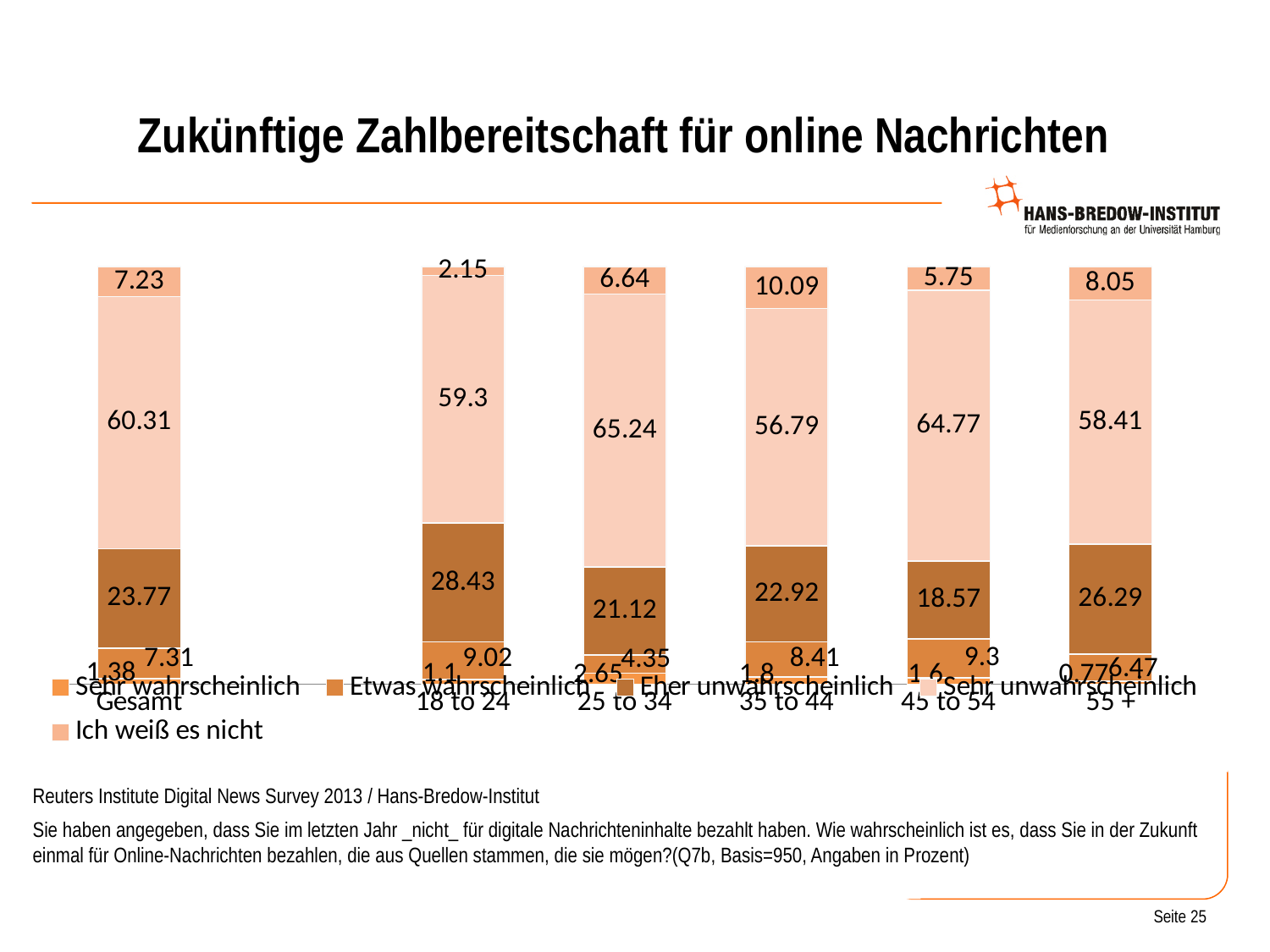
How many series does the chart's legend list? 5 What is the value for 'Ich weiß es nicht' in the 35 to 44 group? 10.09 How many categories (groups) are shown along the x axis of the chart? 6 Which group has the larger 'Eher unwahrscheinlich' value, 18 to 24 or 55 +? 18 to 24 What is the title of the chart on the slide? Zukünftige Zahlbereitschaft für online Nachrichten What is the value for 'Eher unwahrscheinlich' in the Gesamt group? 23.77 What is the difference between the 'Etwas wahrscheinlich' values for 18 to 24 and 25 to 34? 4.67 What is the value for 'Sehr unwahrscheinlich' in the 25 to 34 group? 65.24 Which group has the highest value for 'Sehr unwahrscheinlich'? 25 to 34 Which group has the lowest value for 'Ich weiß es nicht'? 18 to 24 What kind of chart is shown on the slide? Stacked bar chart Which group has the highest value for 'Eher unwahrscheinlich'? 18 to 24